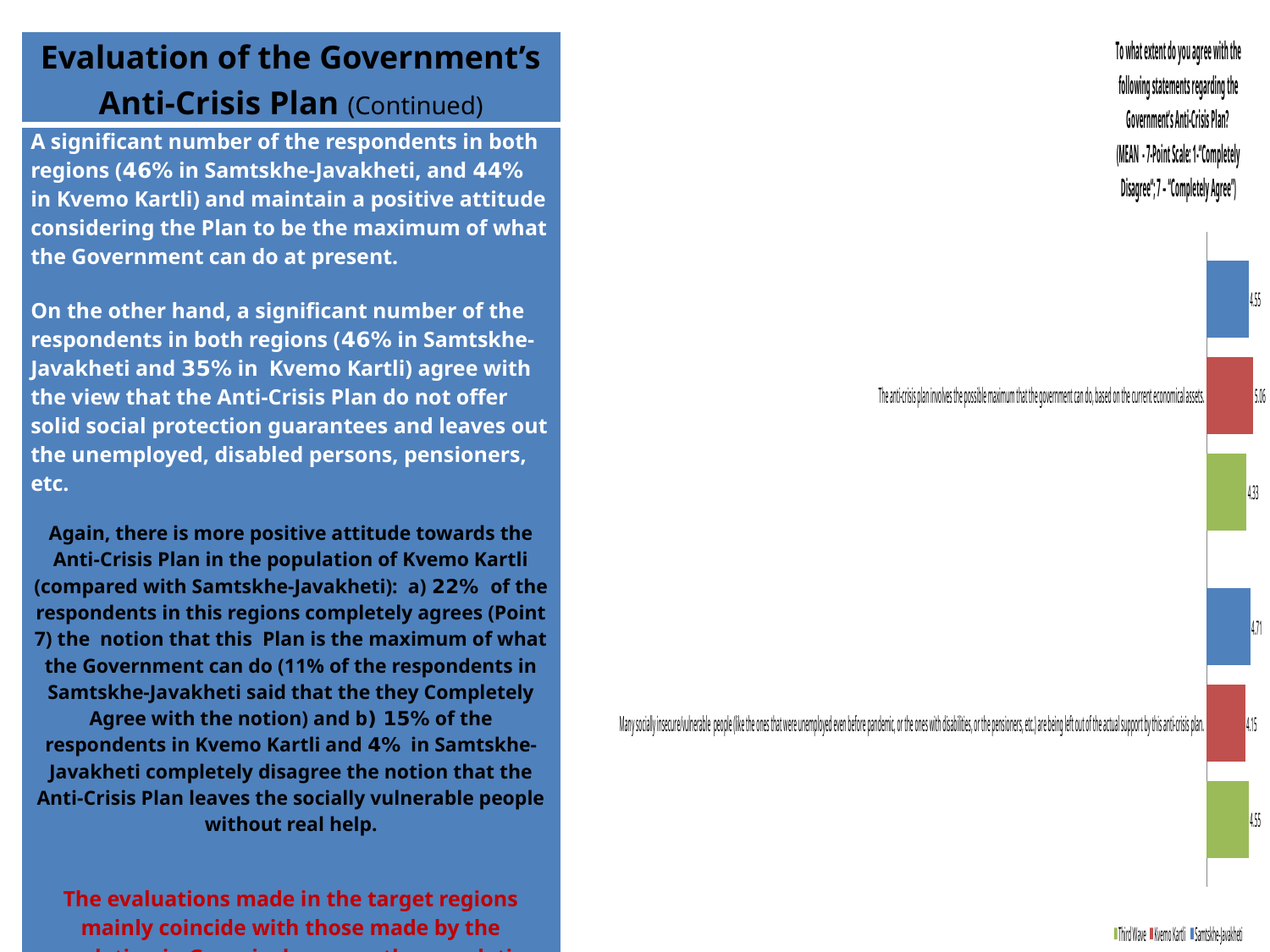
Which series has the highest mean score for the statement that the anti-crisis plan involves the possible maximum that the government can do? Kvemo Kartli For the statement that many socially insecure/vulnerable people are being left out of the actual support, which is larger: the Samtskhe-Javakheti score or the Third Wave score? Samtskhe-Javakheti Which series has the lowest mean score for the statement that many socially insecure/vulnerable people are being left out of the actual support by this anti-crisis plan? Kvemo Kartli What is the Third Wave mean score for the statement that the anti-crisis plan involves the possible maximum that the government can do? 4.33 What is the Kvemo Kartli mean score for the statement that the anti-crisis plan involves the possible maximum that the government can do? 5.06 How many statements (categories) are plotted in the chart? 2 How many series does the chart legend list? 3 What kind of chart is shown on the slide? bar chart What is the Samtskhe-Javakheti mean score for the statement that the anti-crisis plan involves the possible maximum that the government can do? 4.55 What is the difference between the Kvemo Kartli and Samtskhe-Javakheti mean scores for the statement that the anti-crisis plan involves the possible maximum that the government can do? 0.51 What is the Samtskhe-Javakheti mean score for the statement that many socially insecure/vulnerable people are being left out of the actual support by this anti-crisis plan? 4.71 What is the Kvemo Kartli mean score for the statement that many socially insecure/vulnerable people are being left out of the actual support by this anti-crisis plan? 4.15